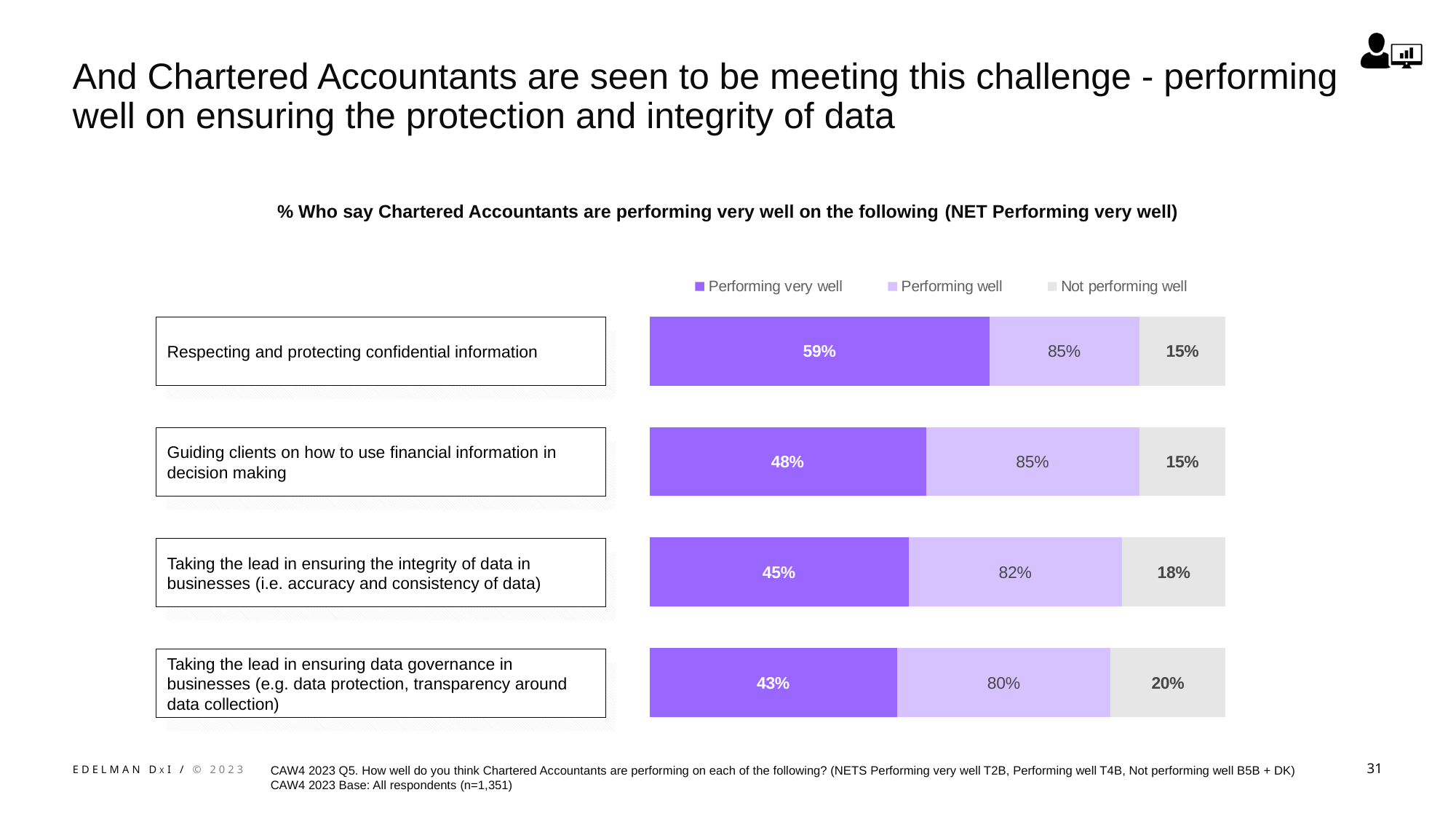
What is the 'Performing very well' value for guiding clients on how to use financial information in decision making? 48% How many items (categories) are shown in the chart? 4 Which item has the highest 'Not performing well' percentage? Taking the lead in ensuring data governance in businesses (e.g. data protection, transparency around data collection) Which item has the highest 'Performing very well' percentage? Respecting and protecting confidential information What is the difference in 'Performing very well' percentage between respecting and protecting confidential information and taking the lead in ensuring data governance in businesses? 16 percentage points What is the 'Not performing well' value for taking the lead in ensuring data governance in businesses? 20% What is the 'Performing well' value for taking the lead in ensuring the integrity of data in businesses? 82% How many series does the legend list? 3 What percentage say Chartered Accountants are performing very well on respecting and protecting confidential information? 59% What type of chart is shown on the slide? Stacked horizontal bar chart Which is larger: the 'Performing very well' value for guiding clients on how to use financial information in decision making, or for taking the lead in ensuring the integrity of data in businesses? Guiding clients on how to use financial information in decision making Which item has the lowest 'Performing very well' percentage? Taking the lead in ensuring data governance in businesses (e.g. data protection, transparency around data collection)